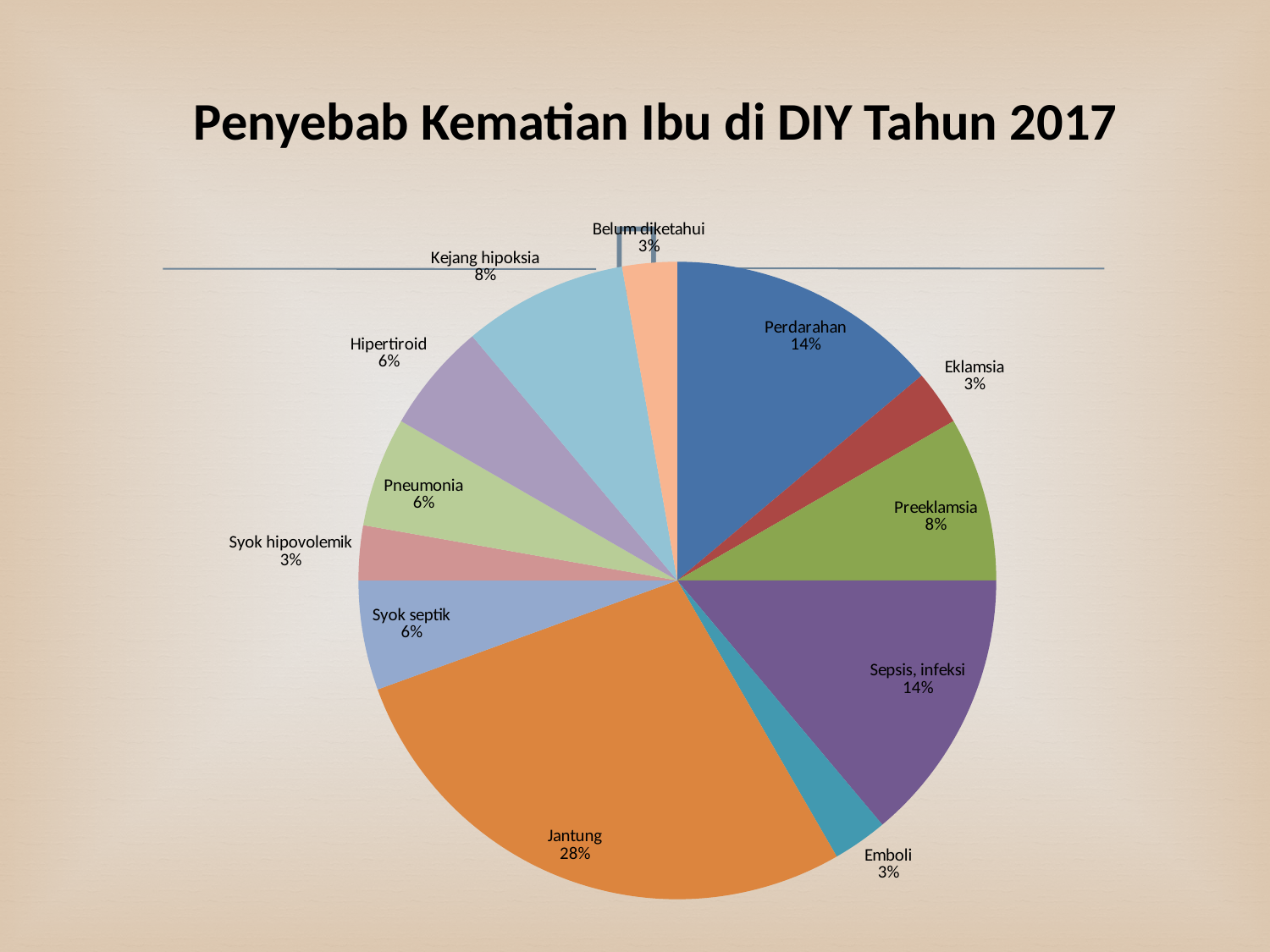
Which is larger, the share for Preeklamsia or the share for Eklamsia? Preeklamsia How many categories (slices) are shown in the pie chart? 12 What is the difference between the share for Jantung and the share for Sepsis, infeksi? 14% What is the value shown for Hipertiroid? 6% What is the value shown for Emboli? 3% What is the value shown for Perdarahan? 14% What is the difference between the share for Perdarahan and the share for Syok septik? 8% What share of the pie does Jantung represent? 28% What kind of chart is shown on the slide? Pie chart What is the value shown for Kejang hipoksia? 8% Which category has the largest slice of the pie? Jantung What is the title of the chart? Penyebab Kematian Ibu di DIY Tahun 2017